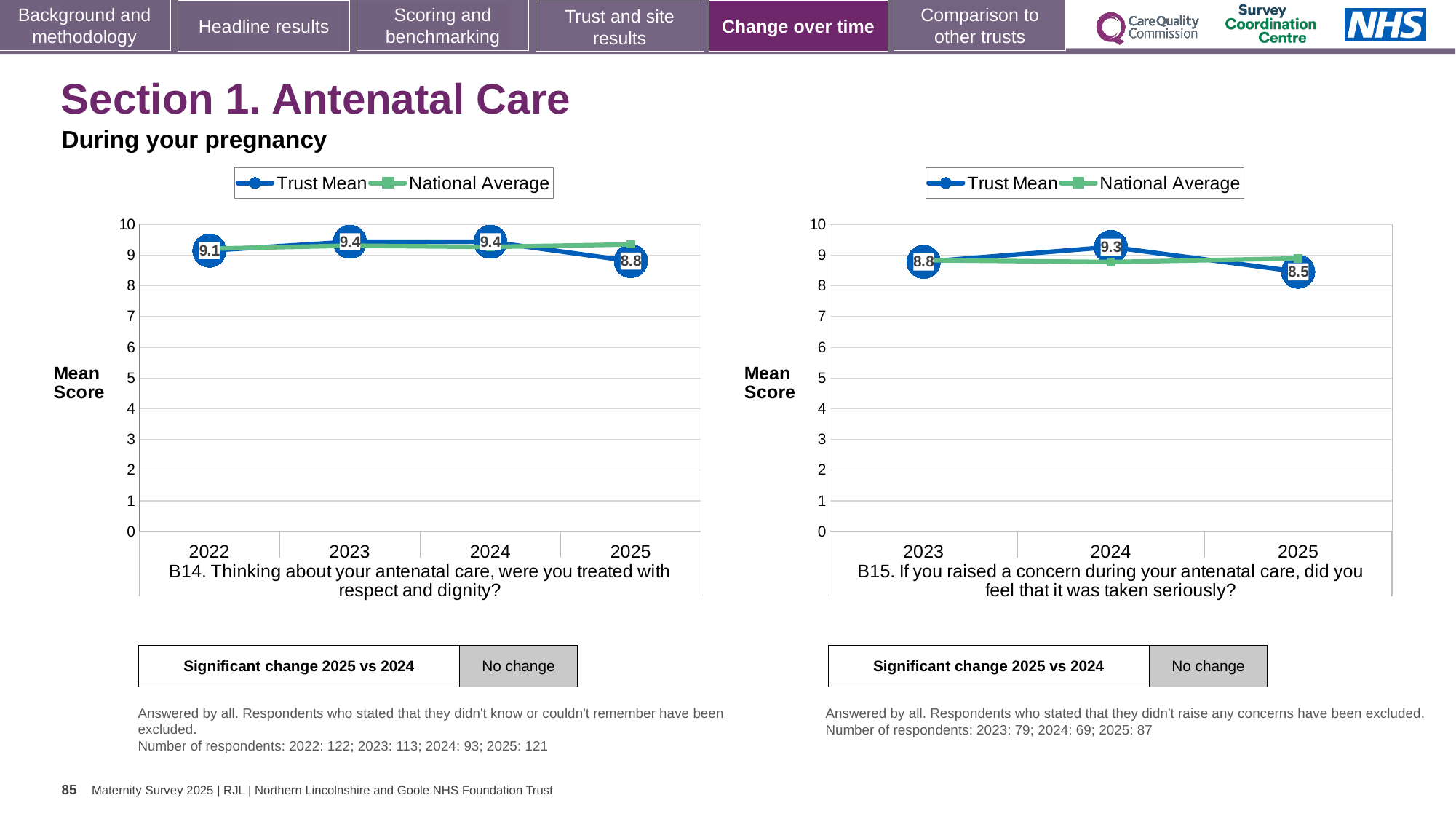
On the right chart (B15), what is the Trust Mean score for 2025? 8.5 On the left chart (B14), which year has the lowest Trust Mean score? 2025 On the right chart (B15), what is the difference between the Trust Mean scores for 2024 and 2025? 0.8 On the left chart (B14), what is the Trust Mean score for 2022? 9.1 How many years are plotted on the left chart (B14)? 4 How many series does the legend of the right chart (B15) list? 2 What kind of chart is the left chart (B14)? line chart On the right chart (B15), which year has the highest Trust Mean score? 2024 On the left chart (B14), what is the Trust Mean score for 2025? 8.8 On the right chart (B15), what is the Trust Mean score for 2024? 9.3 On the left chart (B14), what is the difference between the Trust Mean scores for 2023 and 2025? 0.6 On the right chart (B15), is the Trust Mean score for 2023 larger or smaller than the score for 2025? larger